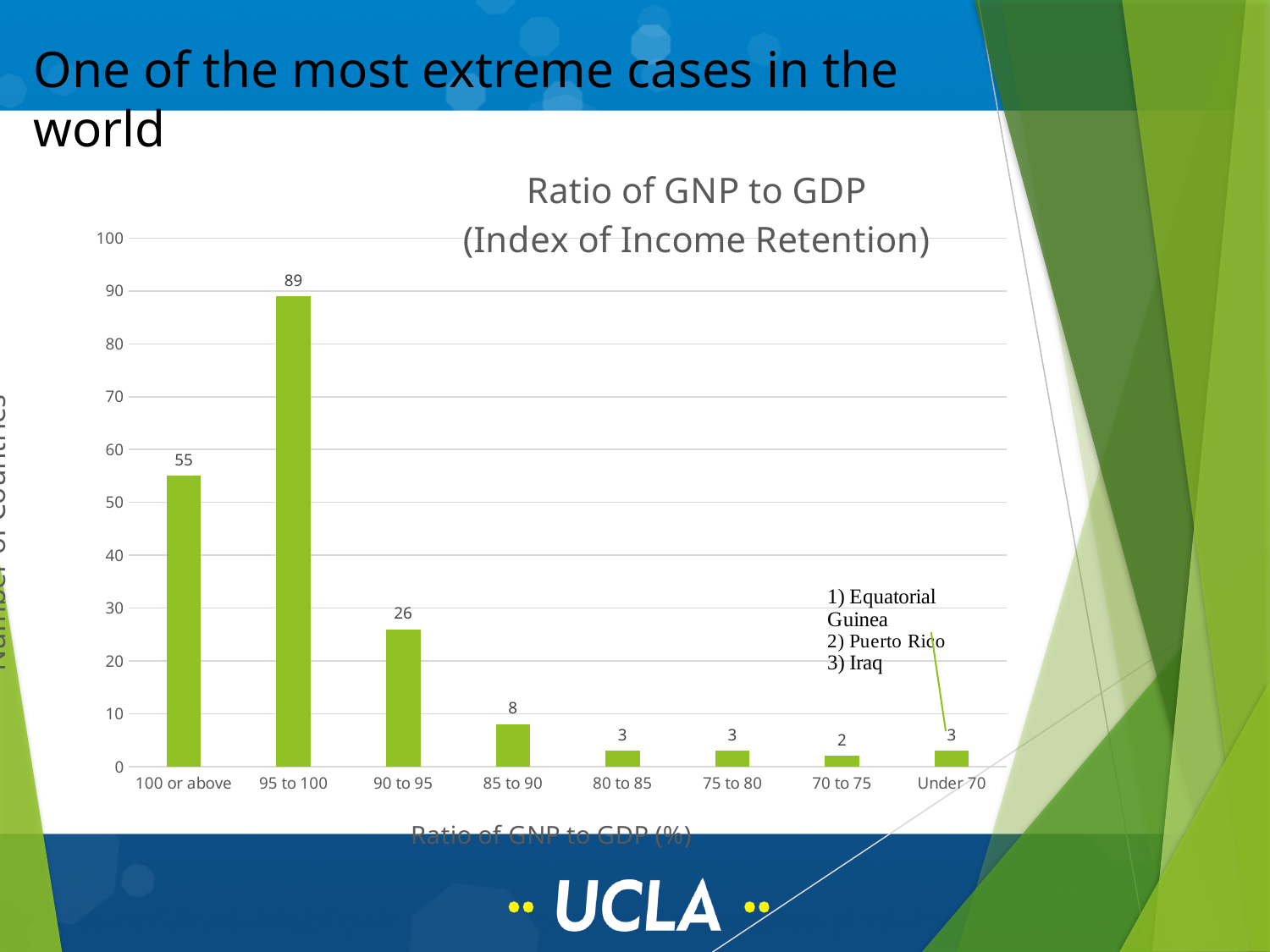
What is the value for the '100 or above' category? 55 Is the value for '95 to 100' greater or less than 80? greater What kind of chart is shown on the slide? bar chart What is the value for the '70 to 75' category? 2 What is the difference between the values for '95 to 100' and '100 or above'? 34 Which category has the lowest number of countries? 70 to 75 What is the value for the '90 to 95' category? 26 How many countries have a ratio of GNP to GDP of 95 to 100? 89 Which category has the highest number of countries? 95 to 100 What is the title of the chart? Ratio of GNP to GDP (Index of Income Retention) Which is larger, the value for '90 to 95' or the value for '85 to 90'? 90 to 95 How many categories are shown on the x axis? 8